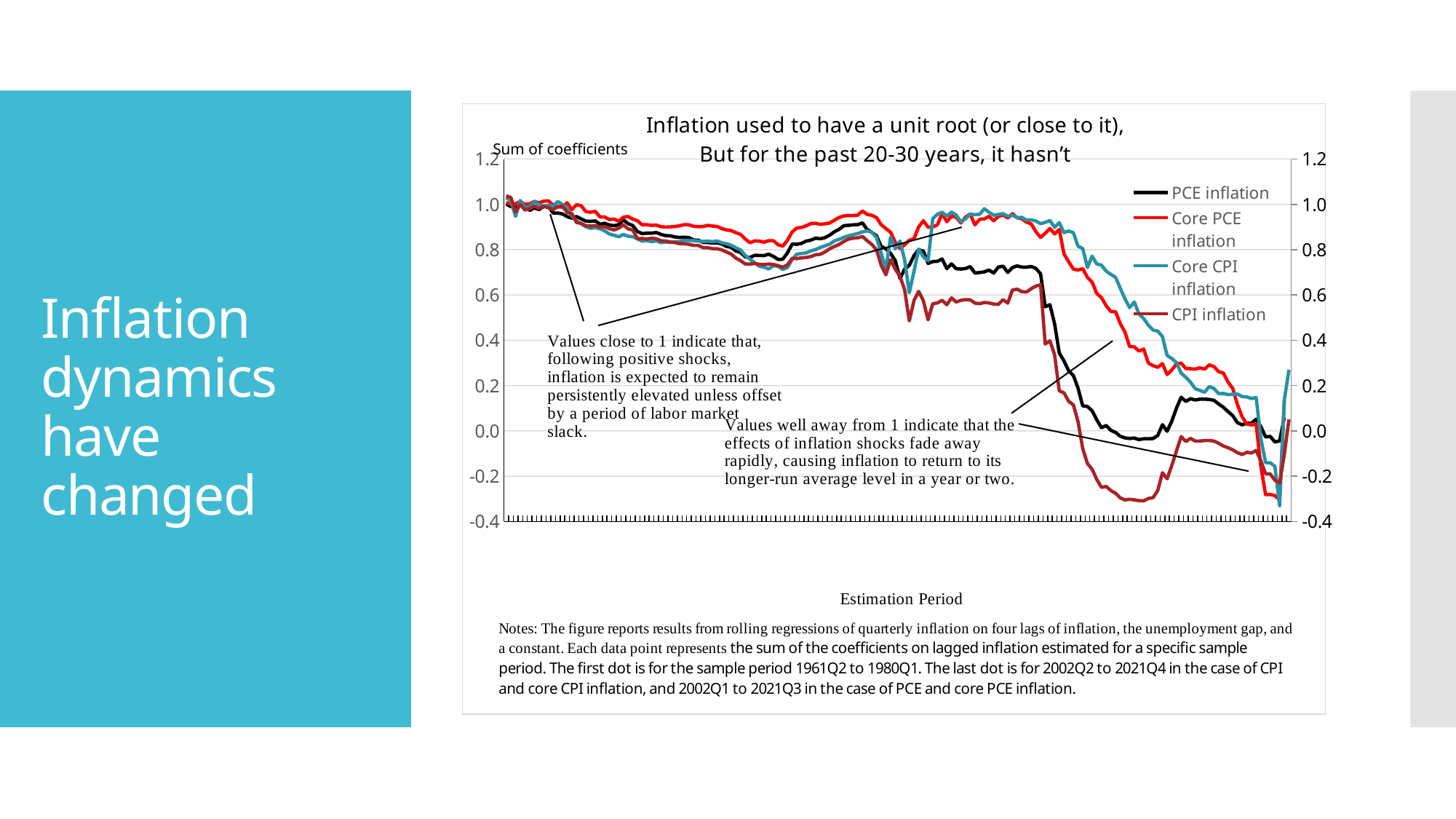
At the start of the estimation period, is the value for CPI inflation greater or less than 0.8? greater At the start of the estimation period, is the value for PCE inflation greater or less than 0.8? greater What is the highest value shown on the y axis? 1.2 What kind of chart is shown on the slide? line chart What is the label of the x axis? Estimation Period At the last data point, which is larger: Core CPI inflation or PCE inflation? Core CPI inflation Overall, do the plotted values rise or fall along the x axis? fall How many series does the legend list? 4 What is the title of the chart? Inflation used to have a unit root (or close to it), But for the past 20-30 years, it hasn't Does the PCE inflation line ever fall below -0.2? no